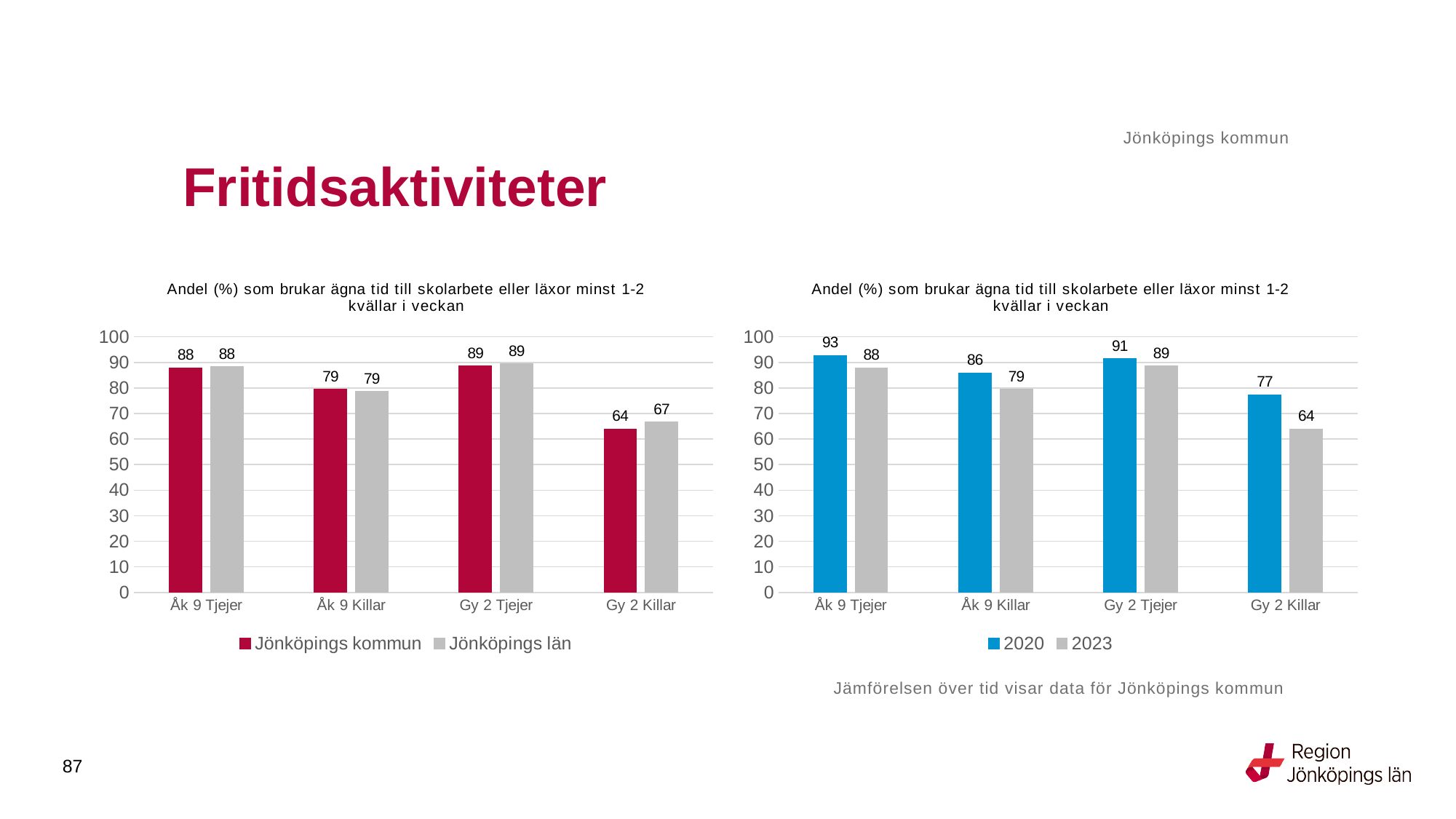
In the right chart, is the 2020 value for Åk 9 Tjejer larger or smaller than the 2023 value for Åk 9 Tjejer? larger What are the two legend entries of the left chart? Jönköpings kommun and Jönköpings län How many categories are shown on the x axis of the left chart? 4 In the right chart, what is the 2023 value for Gy 2 Tjejer? 89 In the left chart, what is the value for Jönköpings kommun for Gy 2 Killar? 64 In the right chart, what is the 2020 value for Åk 9 Killar? 86 What type of chart is the left chart? bar chart How many series does the legend of the right chart list? 2 In the right chart, which category has the highest 2020 value? Åk 9 Tjejer In the left chart, what is the value for Jönköpings län for Gy 2 Killar? 67 In the left chart, which category has the lowest value for Jönköpings kommun? Gy 2 Killar In the right chart, what is the difference between the 2020 and 2023 values for Gy 2 Killar? 13